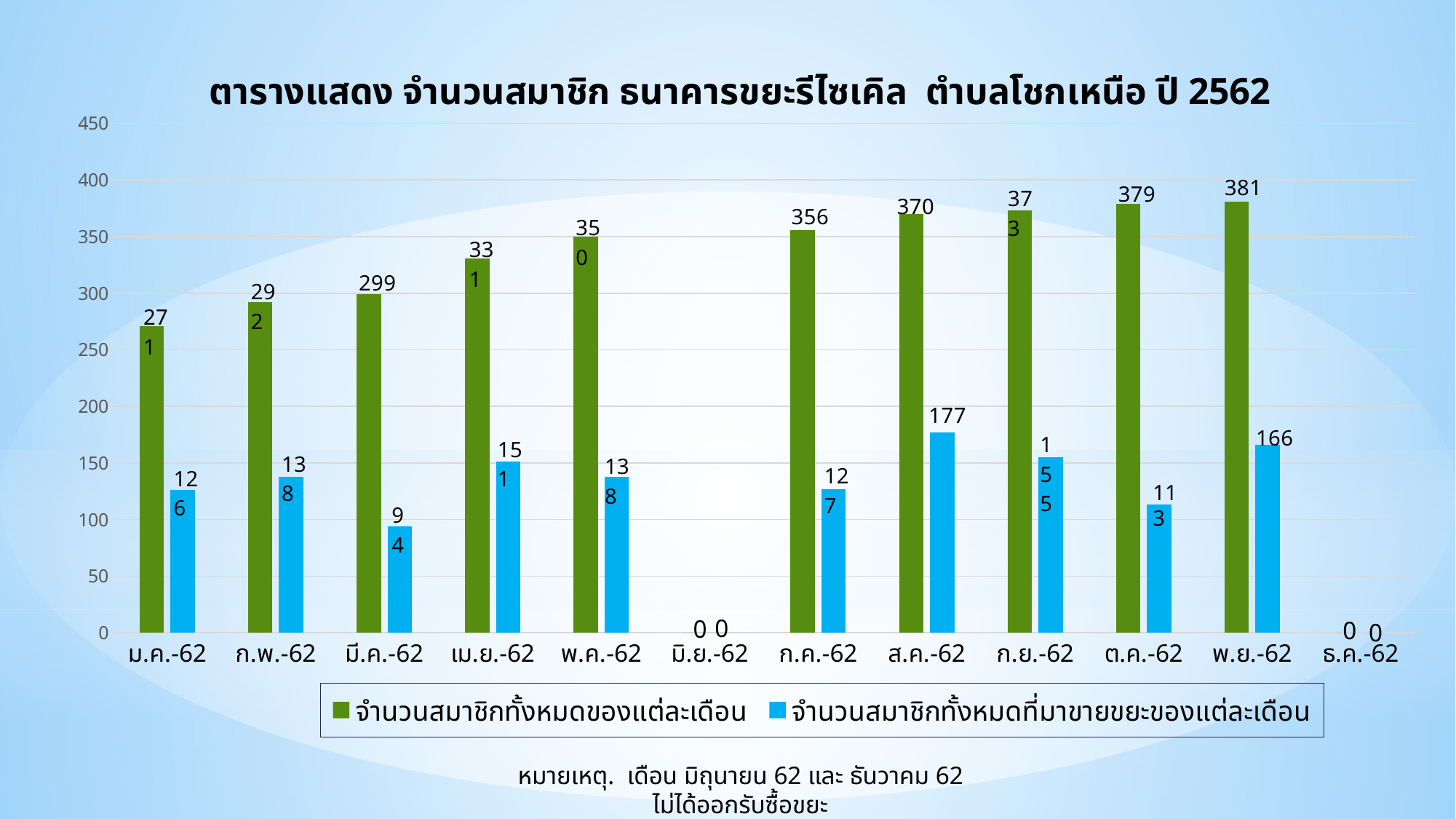
What kind of chart is shown on the slide? bar chart What is the value of จำนวนสมาชิกทั้งหมดของแต่ละเดือน for มี.ค.-62? 299 Which month has the highest value for จำนวนสมาชิกทั้งหมดของแต่ละเดือน? พ.ย.-62 What is the value of จำนวนสมาชิกทั้งหมดของแต่ละเดือน for ก.ค.-62? 356 What is the value of จำนวนสมาชิกทั้งหมดที่มาขายขยะของแต่ละเดือน for พ.ย.-62? 166 What is the value of จำนวนสมาชิกทั้งหมดที่มาขายขยะของแต่ละเดือน for ส.ค.-62? 177 Which month has the highest value for จำนวนสมาชิกทั้งหมดที่มาขายขยะของแต่ละเดือน? ส.ค.-62 How many months (categories) are shown on the x axis? 12 Which is larger: จำนวนสมาชิกทั้งหมดของแต่ละเดือน for ส.ค.-62 or for ก.ค.-62? ส.ค.-62 What is the difference between จำนวนสมาชิกทั้งหมดของแต่ละเดือน for พ.ย.-62 and ต.ค.-62? 2 Is the value of จำนวนสมาชิกทั้งหมดที่มาขายขยะของแต่ละเดือน for มี.ค.-62 greater or less than 100? less How many series does the legend list? 2